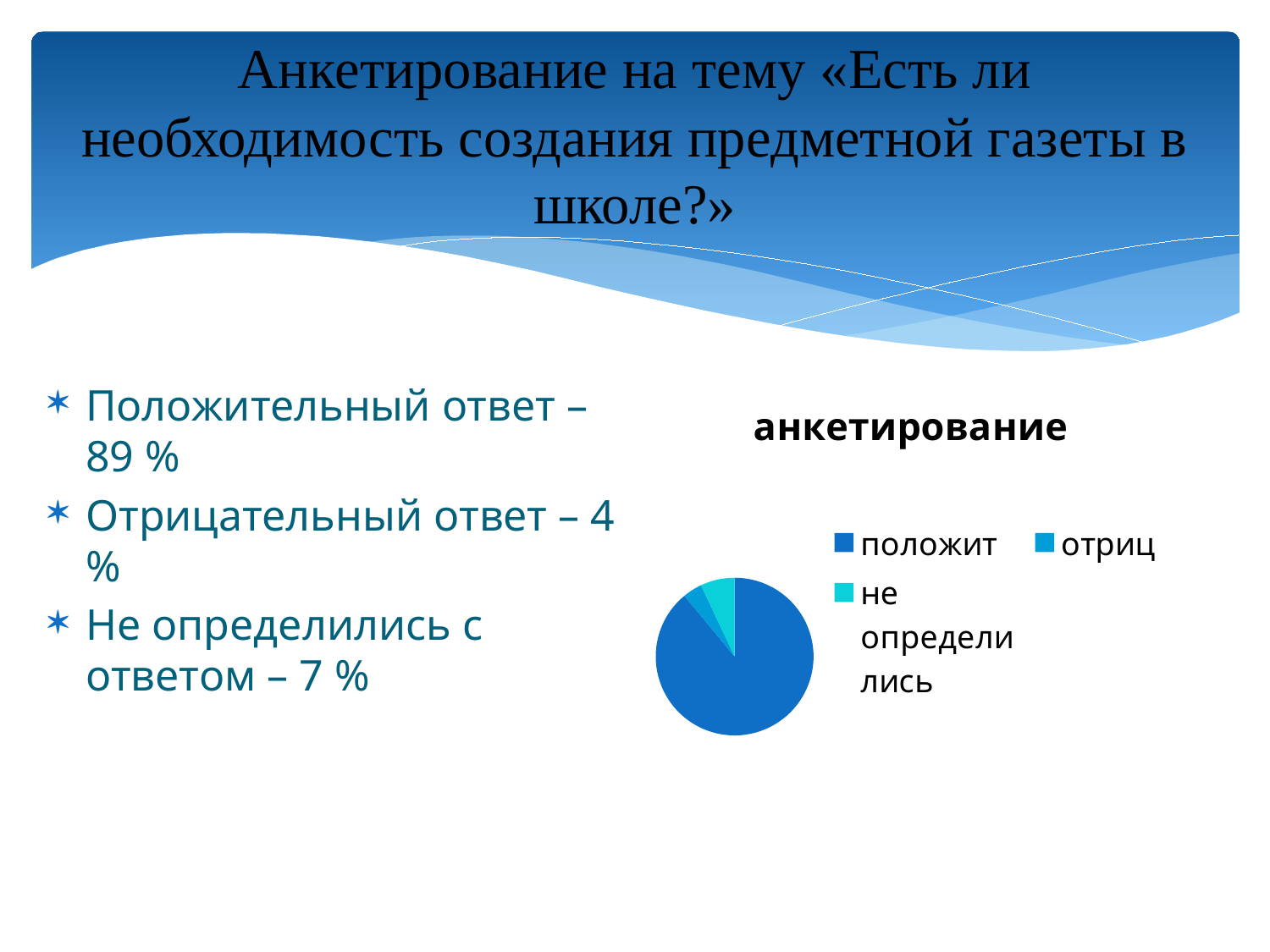
How many entries does the chart legend list? 3 Which slice is larger, положит or отриц? положит According to the slide, what share of respondents gave a positive answer (положит)? 89 % According to the slide, what share of respondents were undecided (не определились)? 7 % According to the slide, what share of respondents gave a negative answer (отриц)? 4 % How many slices does the pie chart have? 3 Which category has the smallest slice of the pie? отриц Which slice is larger, отриц or не определились? не определились What kind of chart is shown on the slide? pie chart What colour is the slice for положит in the pie chart? blue Which category has the largest slice of the pie? положит What is the title of the chart? анкетирование